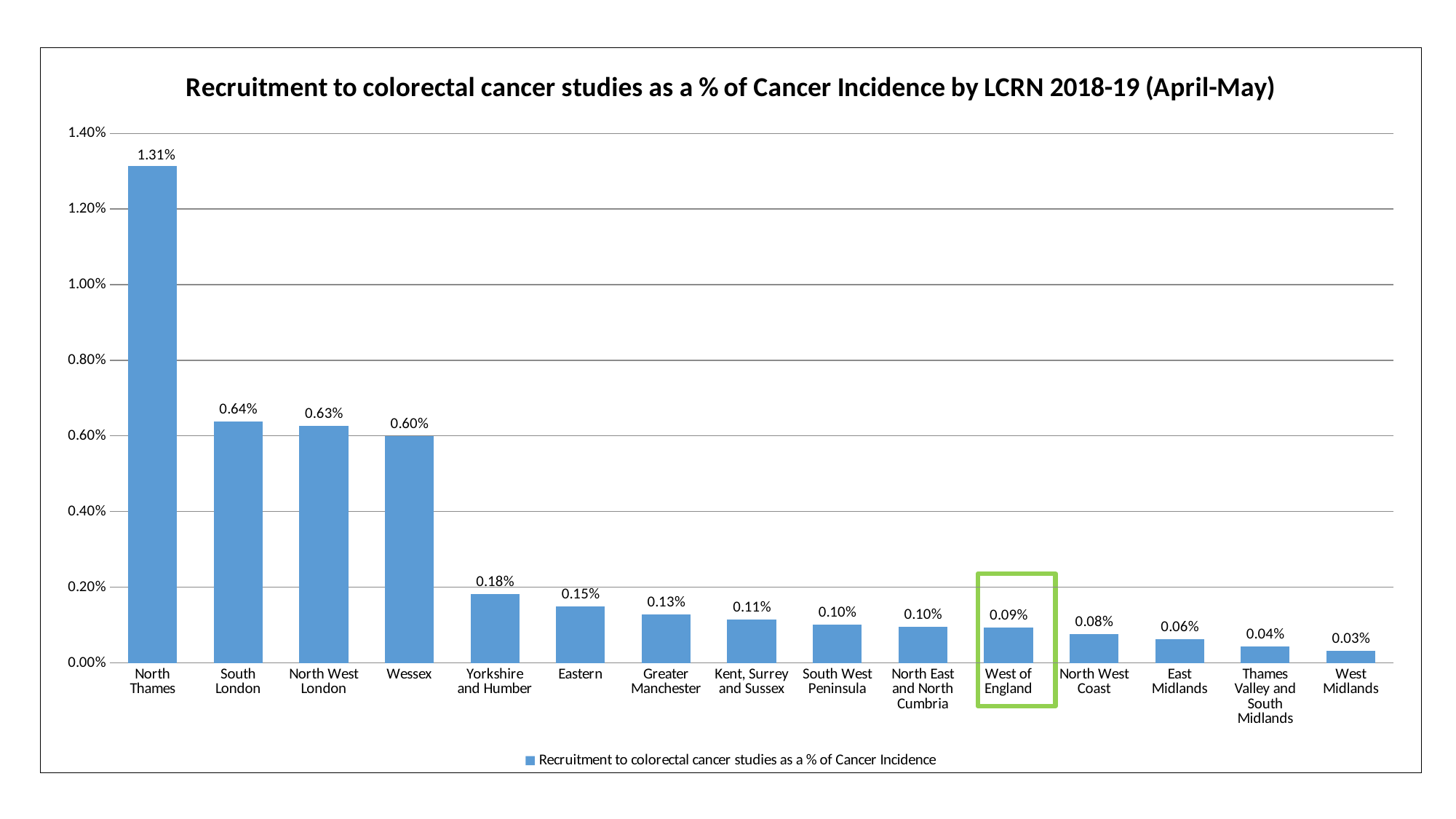
Which LCRN has the lowest recruitment percentage? West Midlands What is the difference between the values for North Thames and South London? 0.67% How many series does the legend list? 1 Which LCRN's bar is highlighted with a green box? West of England Which is larger, the value for Wessex or the value for Eastern? Wessex What is the value for Yorkshire and Humber? 0.18% What is the value for West of England? 0.09% How many LCRNs are shown on the x axis? 15 What is the value for North Thames? 1.31% What kind of chart is shown? Bar chart Is the value for North Thames greater or less than 1.20%? greater Which LCRN has the highest recruitment percentage? North Thames